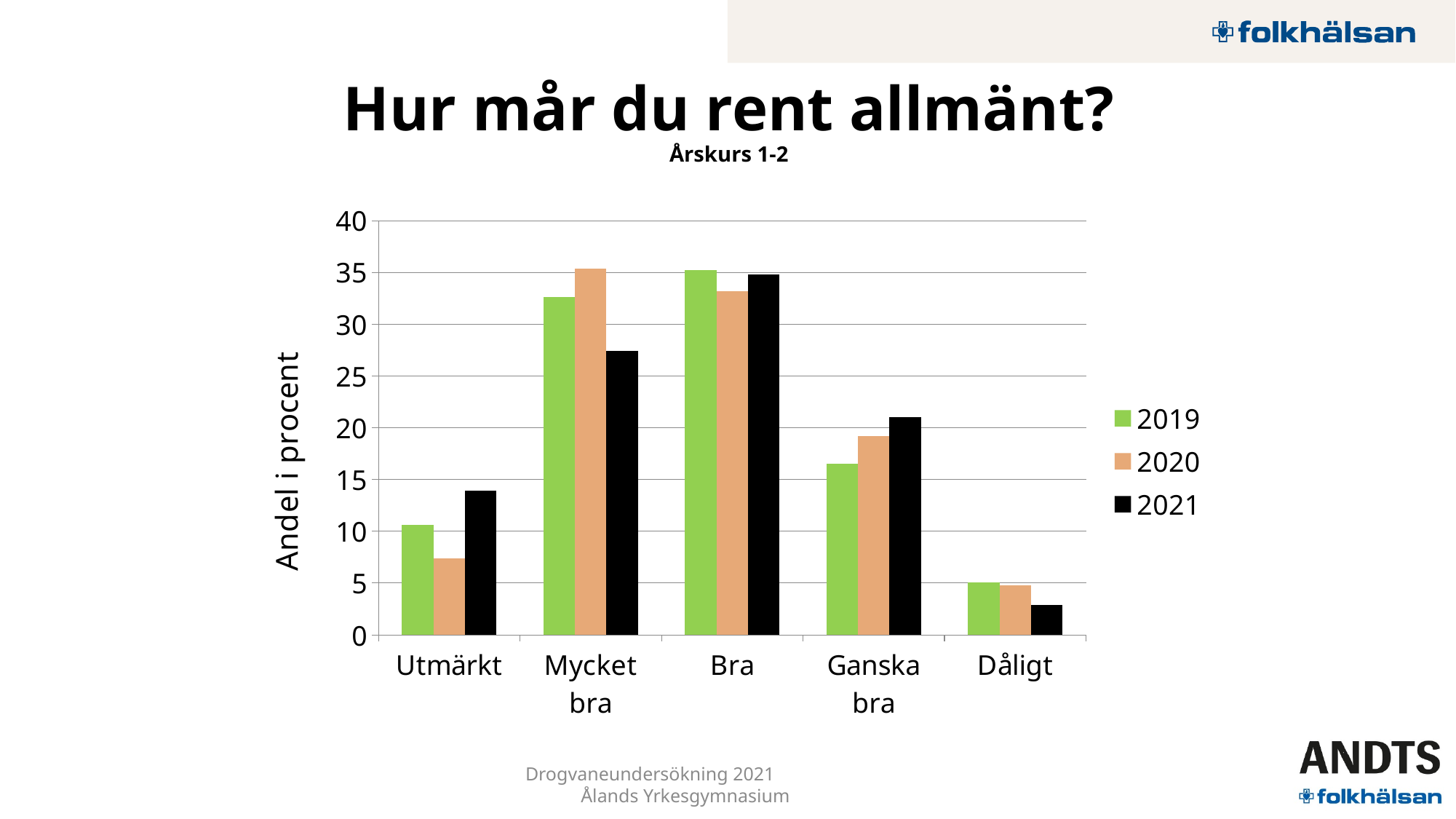
How many series does the legend list? 3 What is the label of the y axis? Andel i procent Is the value for Ganska bra in 2021 greater or less than 20? greater How many categories are shown on the x axis? 5 Is the value for Mycket bra in 2021 greater or less than 30? less For Utmärkt, which is larger: the 2019 value or the 2020 value? 2019 Which category has the highest value for 2021? Bra Is the value for Utmärkt in 2021 greater or less than 10? greater Which category has the lowest value for 2021? Dåligt Which category has the highest value for 2020? Mycket bra What kind of chart is shown on the slide? bar chart